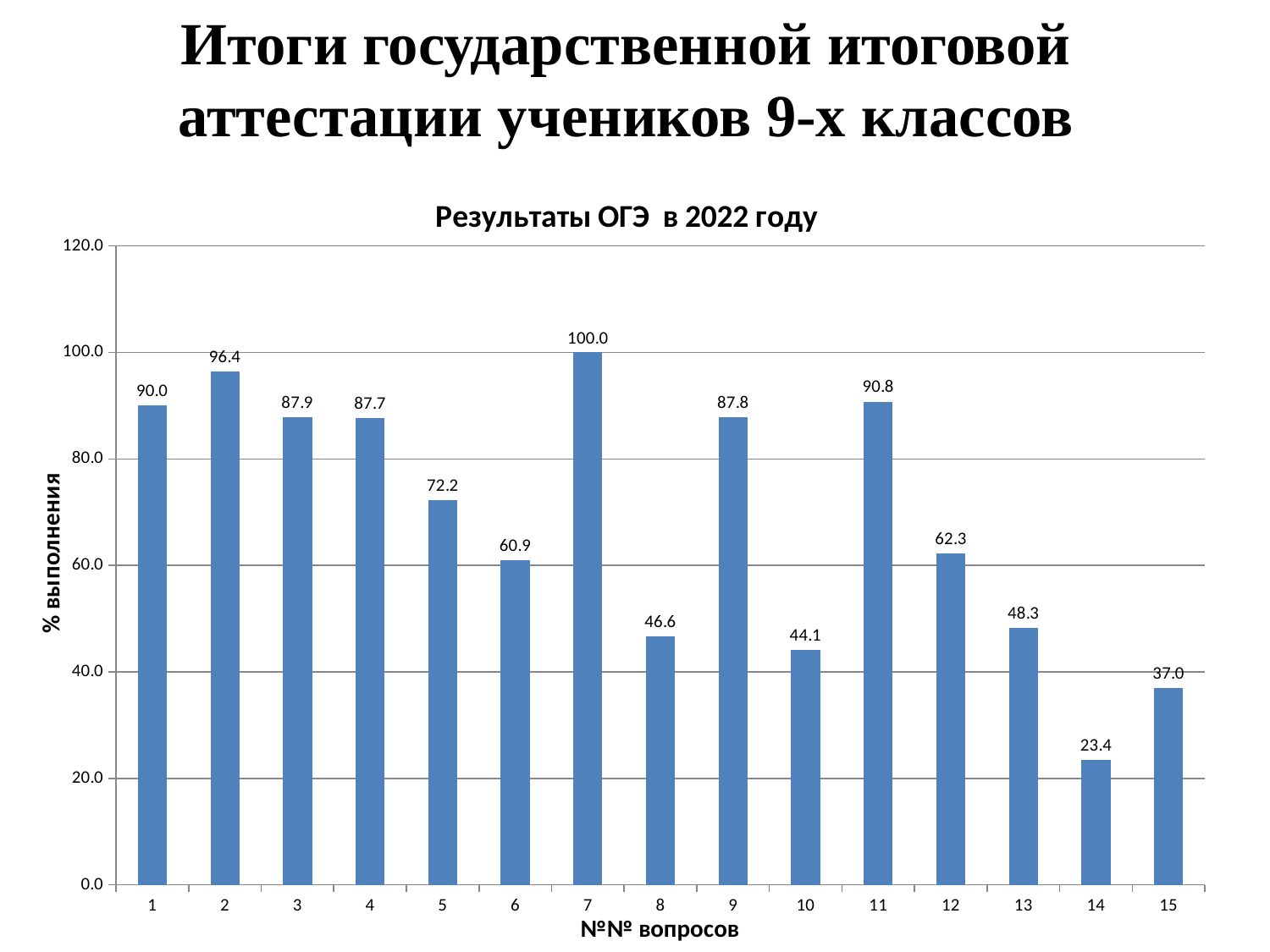
Is the value for question 12 greater or less than 60.0? greater Which has a larger value, question 8 or question 10? question 8 Which question number has the lowest value? 14 What is the value for question 14? 23.4 What is the label of the y axis? % выполнения What is the value for question 7? 100.0 What is the title of the chart? Результаты ОГЭ в 2022 году How many question numbers are shown on the x axis? 15 What is the difference between the values for question 2 and question 15? 59.4 What kind of chart is shown on the slide? bar chart Which question number has the highest value? 7 What is the value for question 5? 72.2